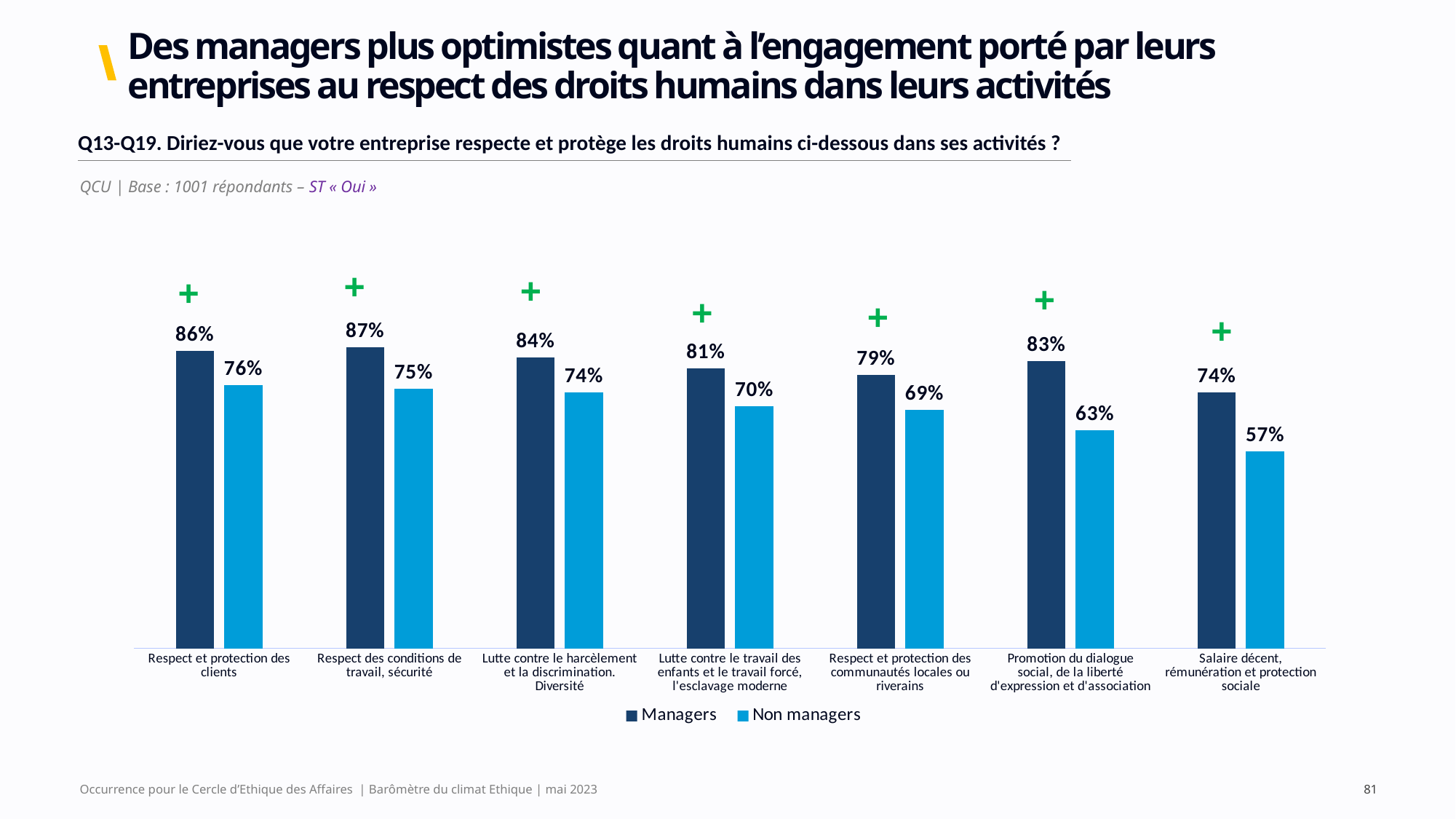
Which series is shown in dark blue? Managers How many series does the legend list? 2 What is the difference between Managers and Non managers for "Promotion du dialogue social, de la liberté d'expression et d'association"? 20 percentage points What is the value for Managers for "Respect et protection des clients"? 86% How many categories are shown on the x axis? 7 What is the value for Non managers for "Salaire décent, rémunération et protection sociale"? 57% What is the difference between Managers and Non managers for "Lutte contre le travail des enfants et le travail forcé, l'esclavage moderne"? 11 percentage points What kind of chart is shown on the slide? Bar chart Which category has the highest value for Managers? Respect des conditions de travail, sécurité What is the value for Non managers for "Promotion du dialogue social, de la liberté d'expression et d'association"? 63% Which category has the lowest value for Non managers? Salaire décent, rémunération et protection sociale Which is larger: the Managers value for "Respect et protection des communautés locales ou riverains" or the Non managers value for "Respect et protection des clients"? Managers value for "Respect et protection des communautés locales ou riverains"